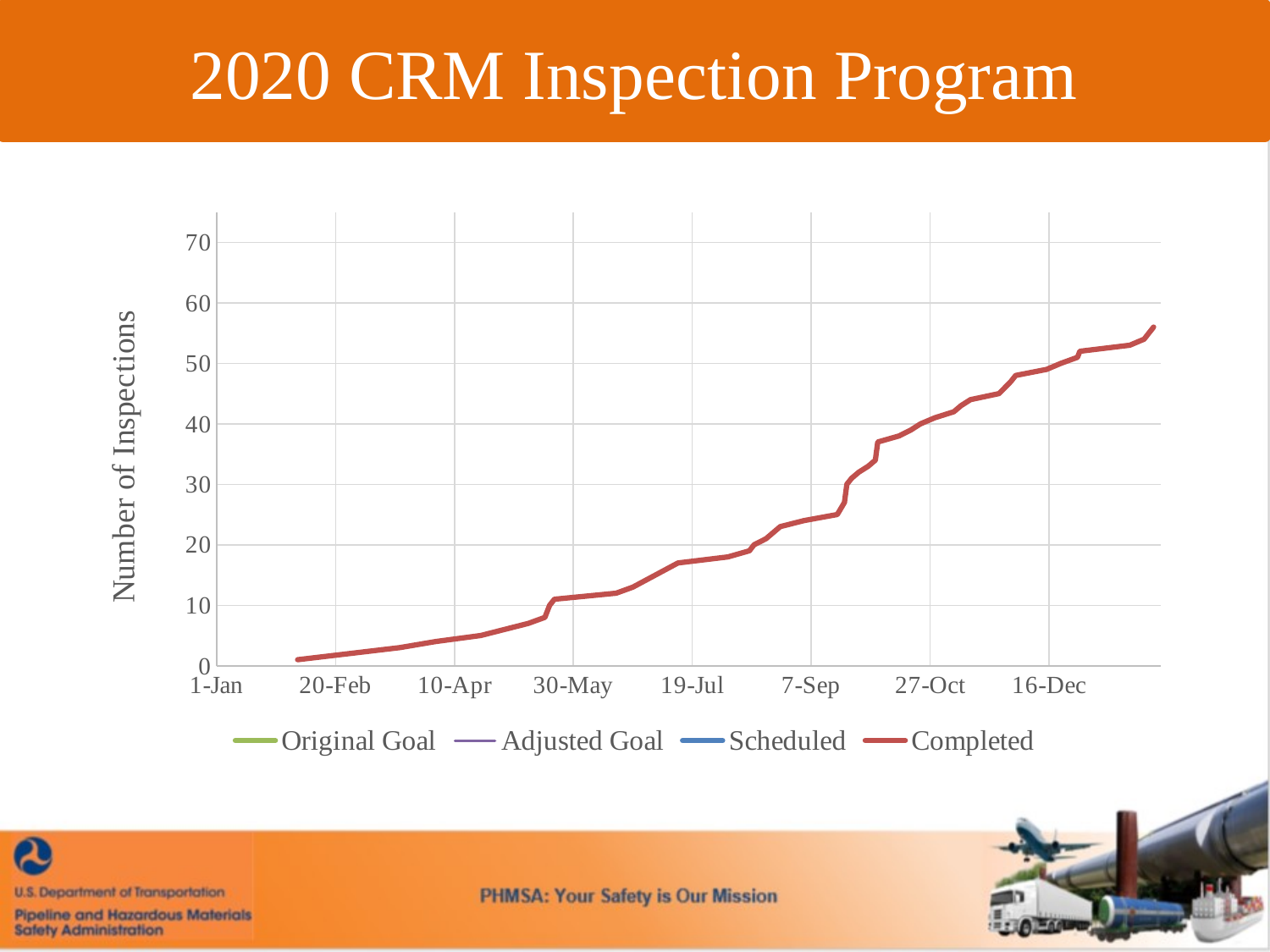
Is the Completed value at 16-Dec greater or less than 40? greater Is the final Completed value at the right end of the line greater or less than 50? greater What is the title of the chart's vertical axis? Number of Inspections Does the Completed line rise or fall from 1-Jan to the end of the year? rise Is the Completed value at 19-Jul greater or less than 20? less What kind of chart is shown on the slide? line chart How many series does the legend list? 4 What colour is the Completed series in the legend? red